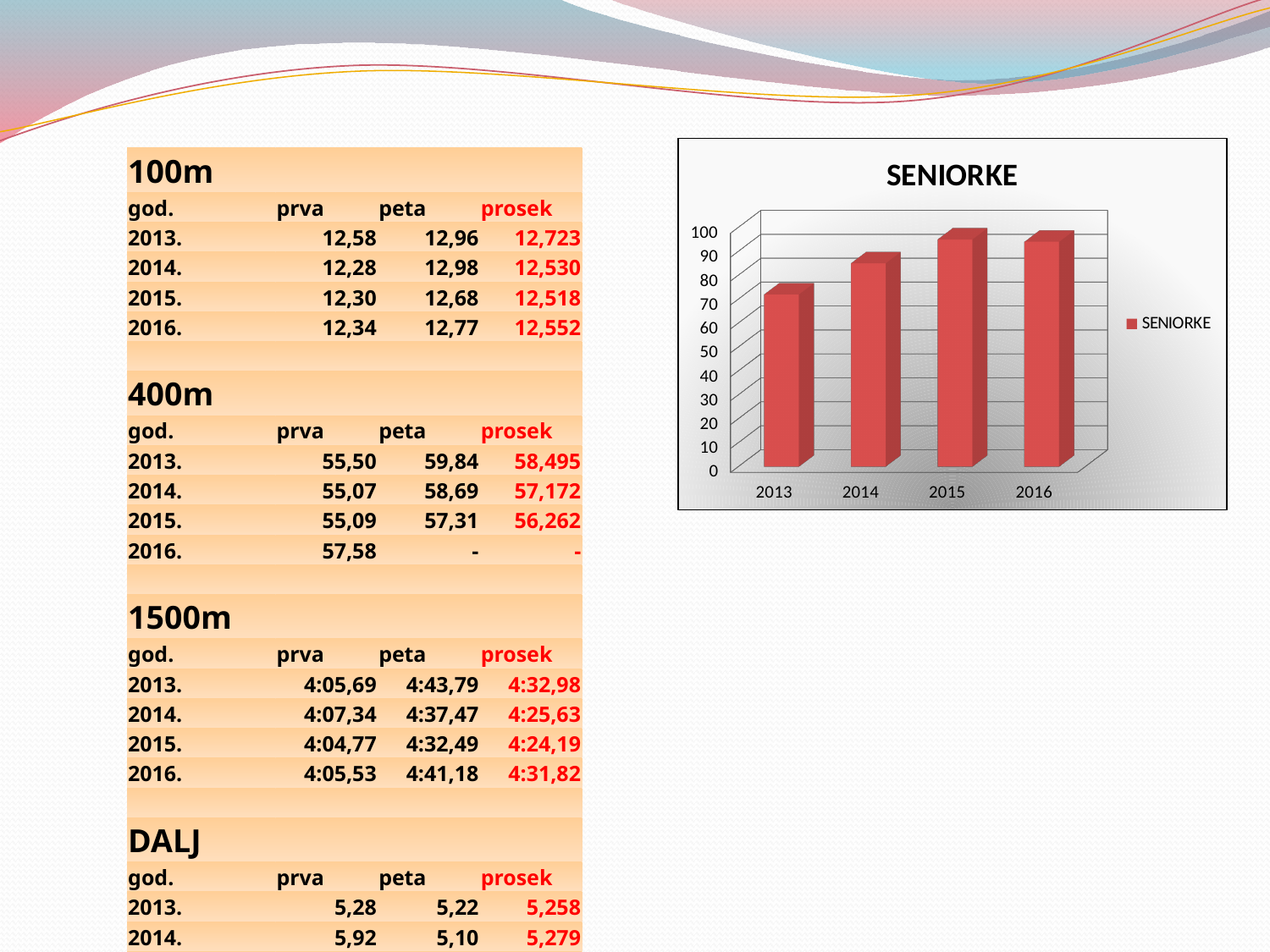
Which year has the lowest bar in the SENIORKE chart? 2013 Is the value for 2015 greater or less than 90? greater How many years are shown on the x axis of the chart? 4 Which is larger, the value for 2013 or the value for 2014? 2014 What kind of chart is shown on the slide? bar chart How many series does the chart legend list? 1 What is the title of the chart? SENIORKE What colour are the bars in the SENIORKE chart? red Is the value for 2014 greater or less than 80? greater Do the values rise or fall from 2013 to 2015? rise Is the value for 2016 greater or less than 80? greater